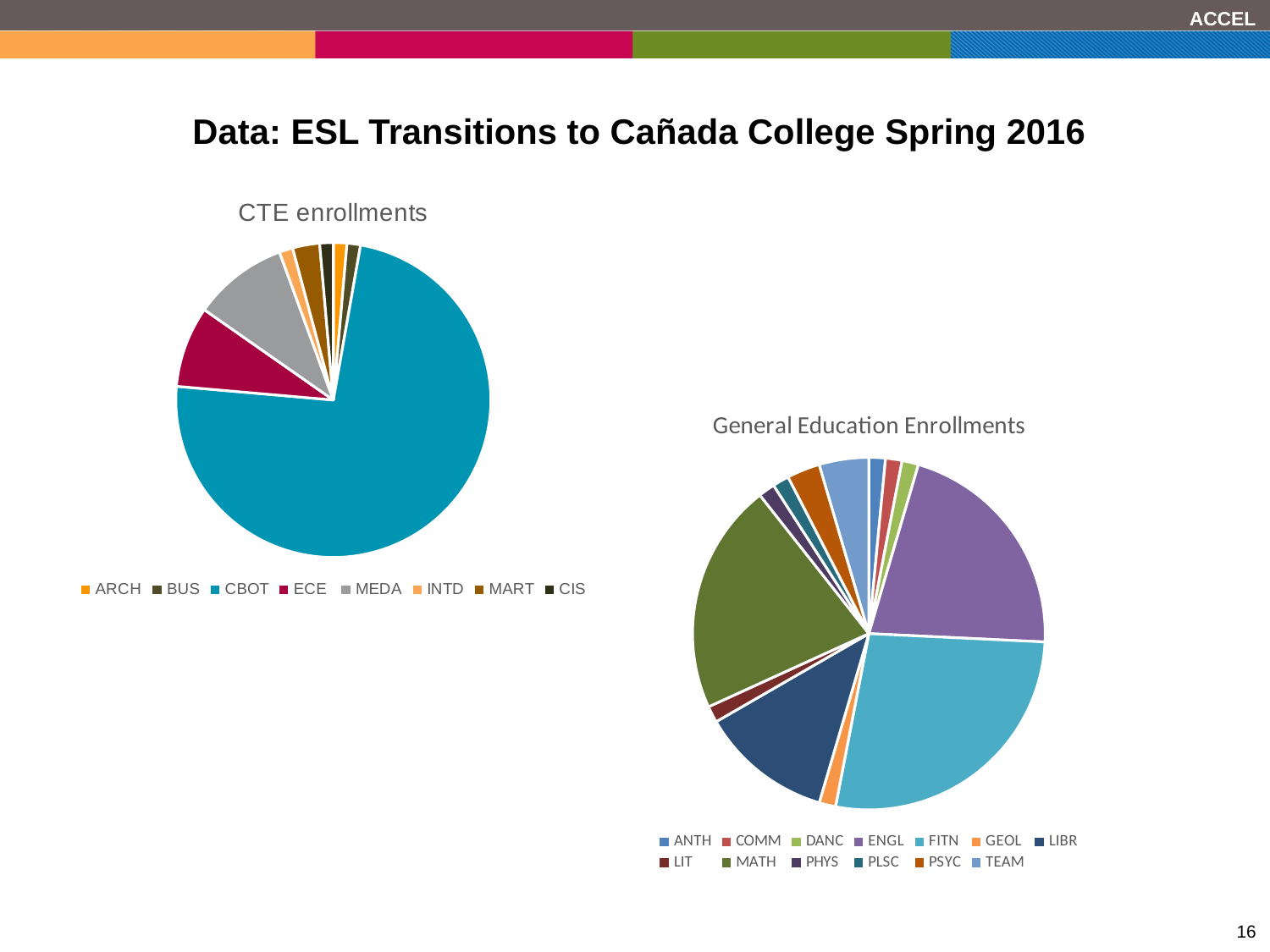
In the General Education Enrollments chart, which slice is larger, ENGL or GEOL? ENGL What is the title of the pie chart on the right side of the slide? General Education Enrollments In the CTE enrollments chart, which category has the largest slice? CBOT In the CTE enrollments chart, does the CBOT slice account for more or less than half of the pie? more In the CTE enrollments chart, which slice is larger, CBOT or ECE? CBOT What is the title of the pie chart on the left side of the slide? CTE enrollments What kind of chart is the General Education Enrollments chart? pie chart In the General Education Enrollments chart, which slice is larger, MATH or LIT? MATH What kind of chart is the CTE enrollments chart? pie chart How many categories does the legend of the CTE enrollments chart list? 8 How many categories does the legend of the General Education Enrollments chart list? 13 In the General Education Enrollments chart, which category has the largest slice? FITN